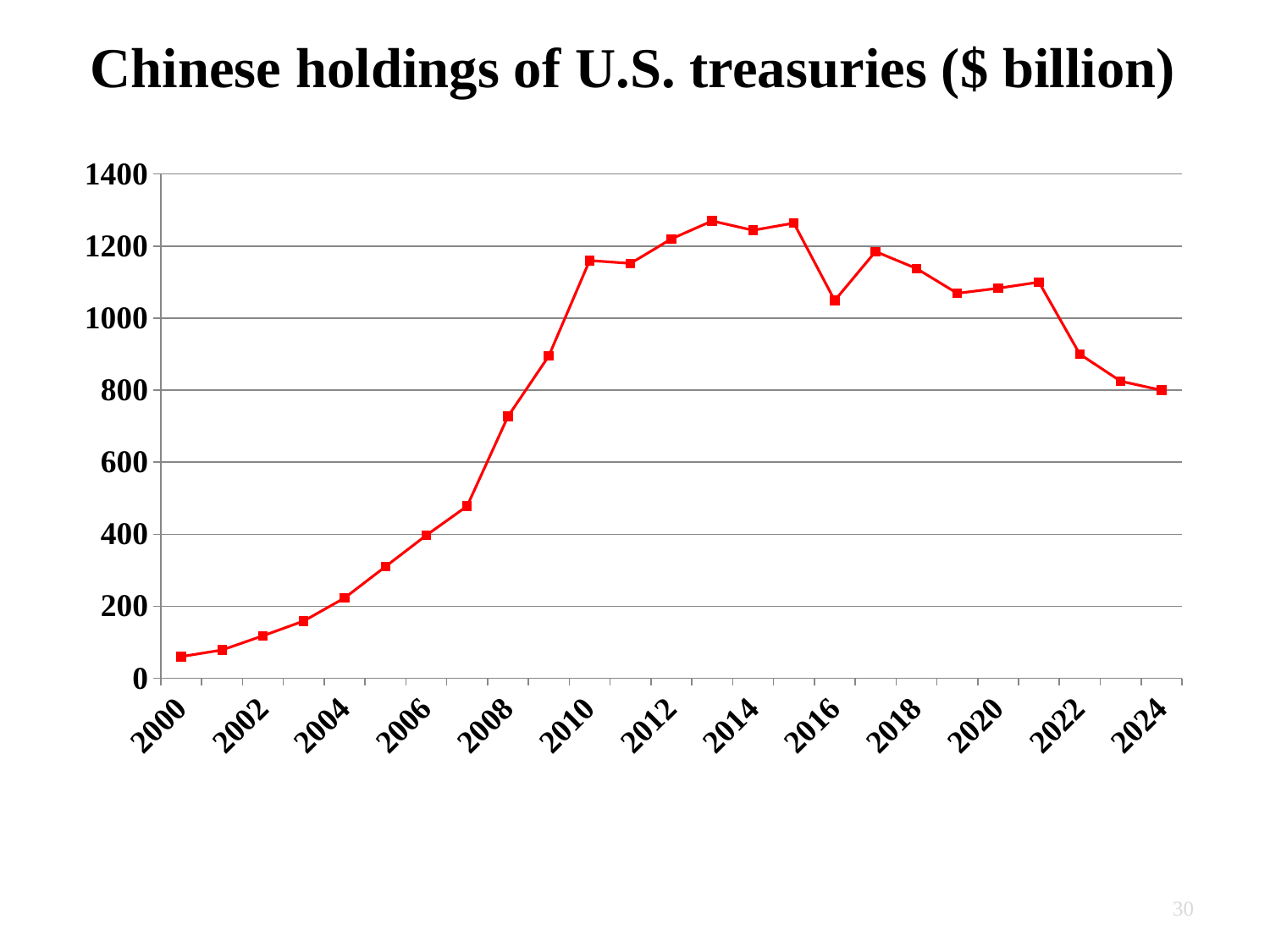
What kind of chart is shown on the slide? line chart Do the values rise or fall from 2021 to 2024? fall How many data points are plotted on the line? 25 Do the values rise or fall from 2000 to 2010? rise Is the value for 2008 greater or less than 600? greater What is the title of the chart? Chinese holdings of U.S. treasuries ($ billion) Which year has the lowest value on the chart? 2000 Is the value for 2022 greater or less than 1000? less Which is larger, the value for 2010 or the value for 2016? 2010 Is the value for 2016 greater or less than 1000? greater Which is larger, the value for 2008 or the value for 2012? 2012